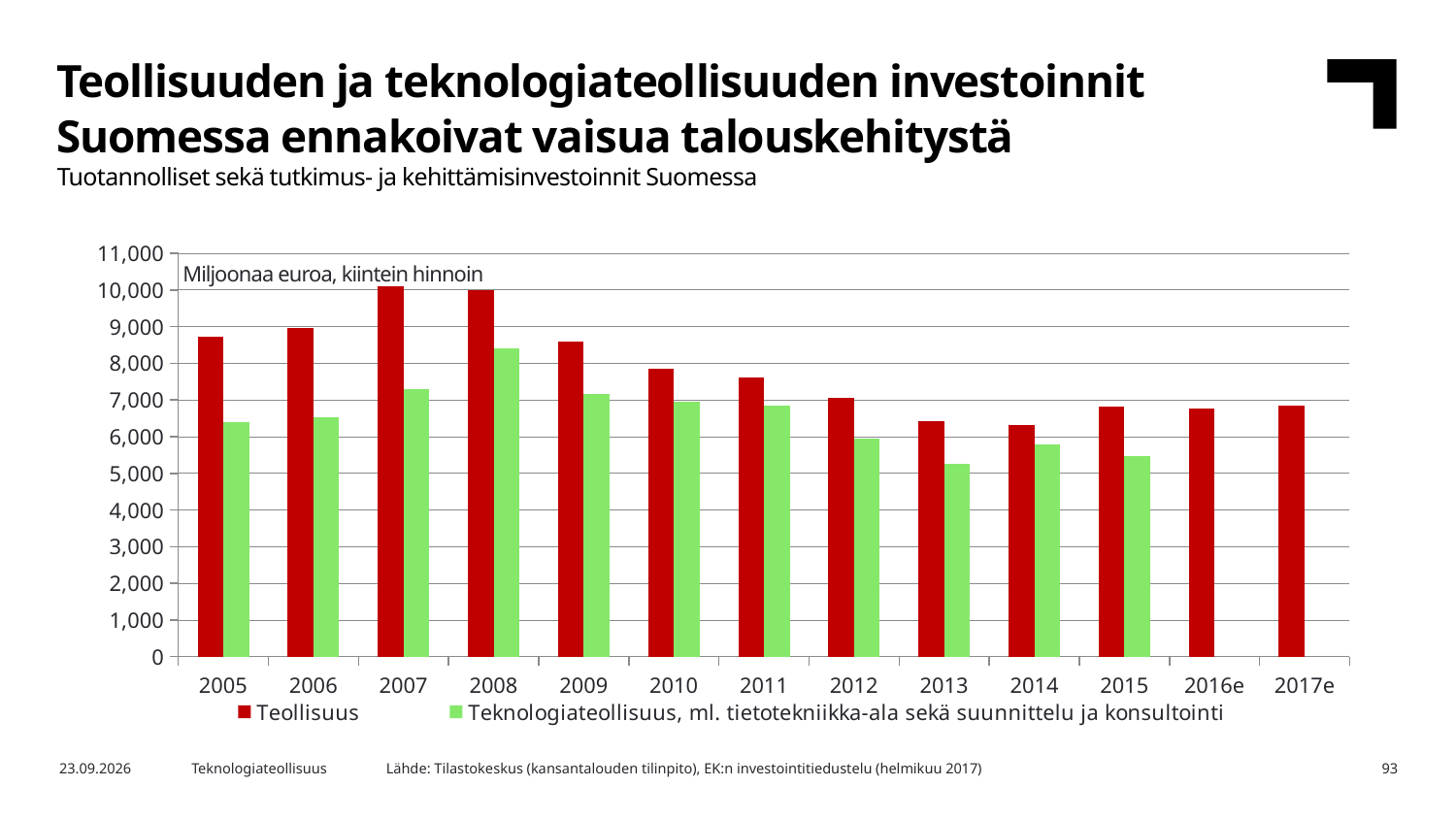
Do the Teollisuus values rise or fall from 2008 to 2014? fall How many series does the legend list? 2 In which year is the Teknologiateollisuus value highest? 2008 In 2008, which series has the larger value, Teollisuus or Teknologiateollisuus? Teollisuus Is the Teollisuus value for 2017e greater or less than 7,000? less What unit is stated in the text box inside the chart? Miljoonaa euroa, kiintein hinnoin What kind of chart is shown on the slide? bar chart How many year categories are shown on the x axis? 13 Is the Teknologiateollisuus value for 2008 greater or less than 8,000? greater Is the Teollisuus value for 2010 greater or less than 8,000? less